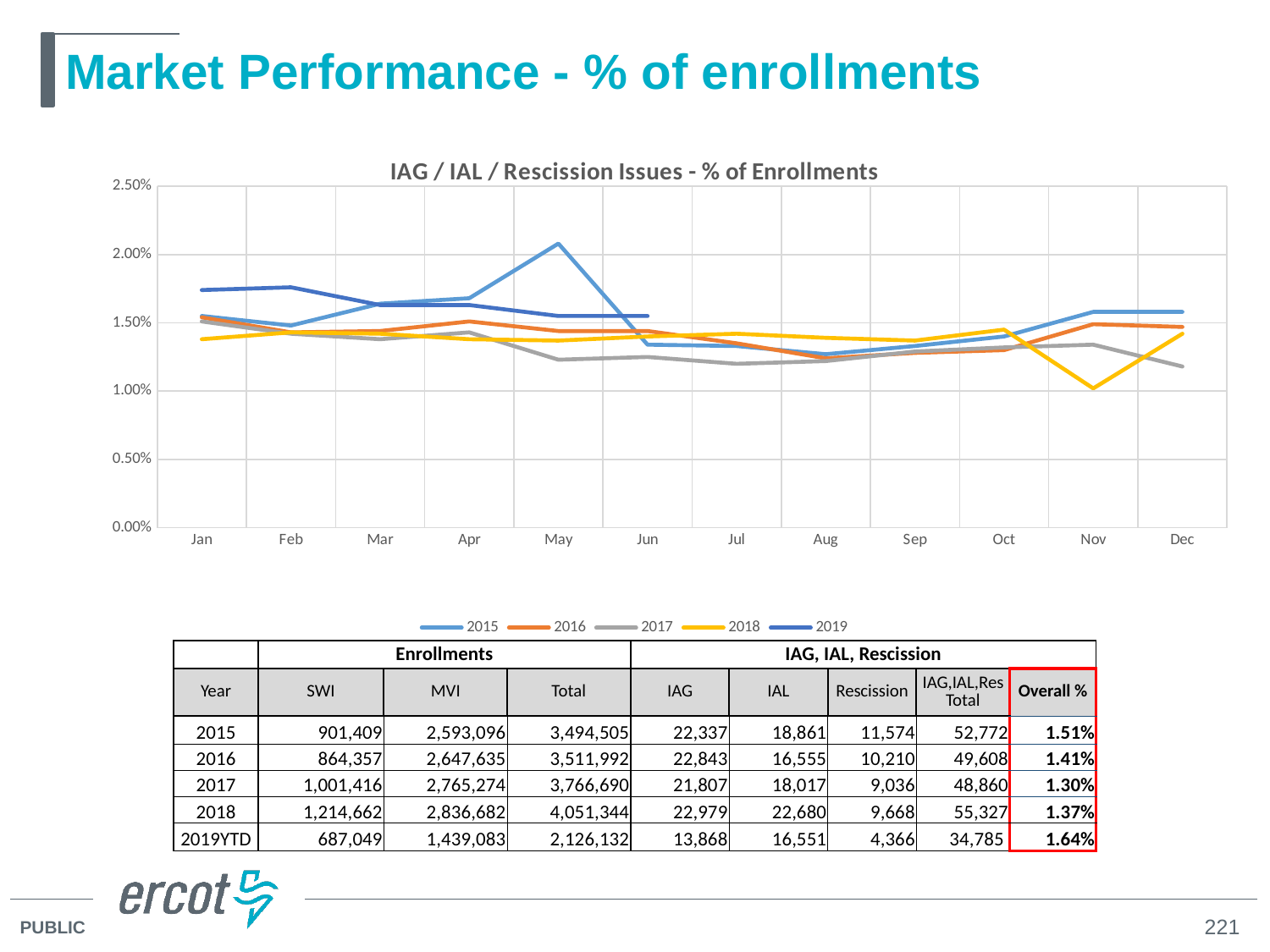
Is the value for 2015 in May greater or less than 2.00%? greater In which month does the 2018 line reach its lowest value? Nov What kind of chart is shown on the slide? Line chart How many series does the chart legend list? 5 How many months are shown along the x axis of the chart? 12 Is the value for 2018 in Nov greater or less than 1.50%? less Which is larger in May, the value for 2015 or the value for 2017? 2015 Does the 2019 line rise or fall from Jan to Jun? Fall In which month does the 2015 line reach its highest value? May Is the value for 2019 in Jan greater or less than 1.50%? greater What is the title of the chart? IAG / IAL / Rescission Issues - % of Enrollments Which series reaches the highest point on the chart? 2015